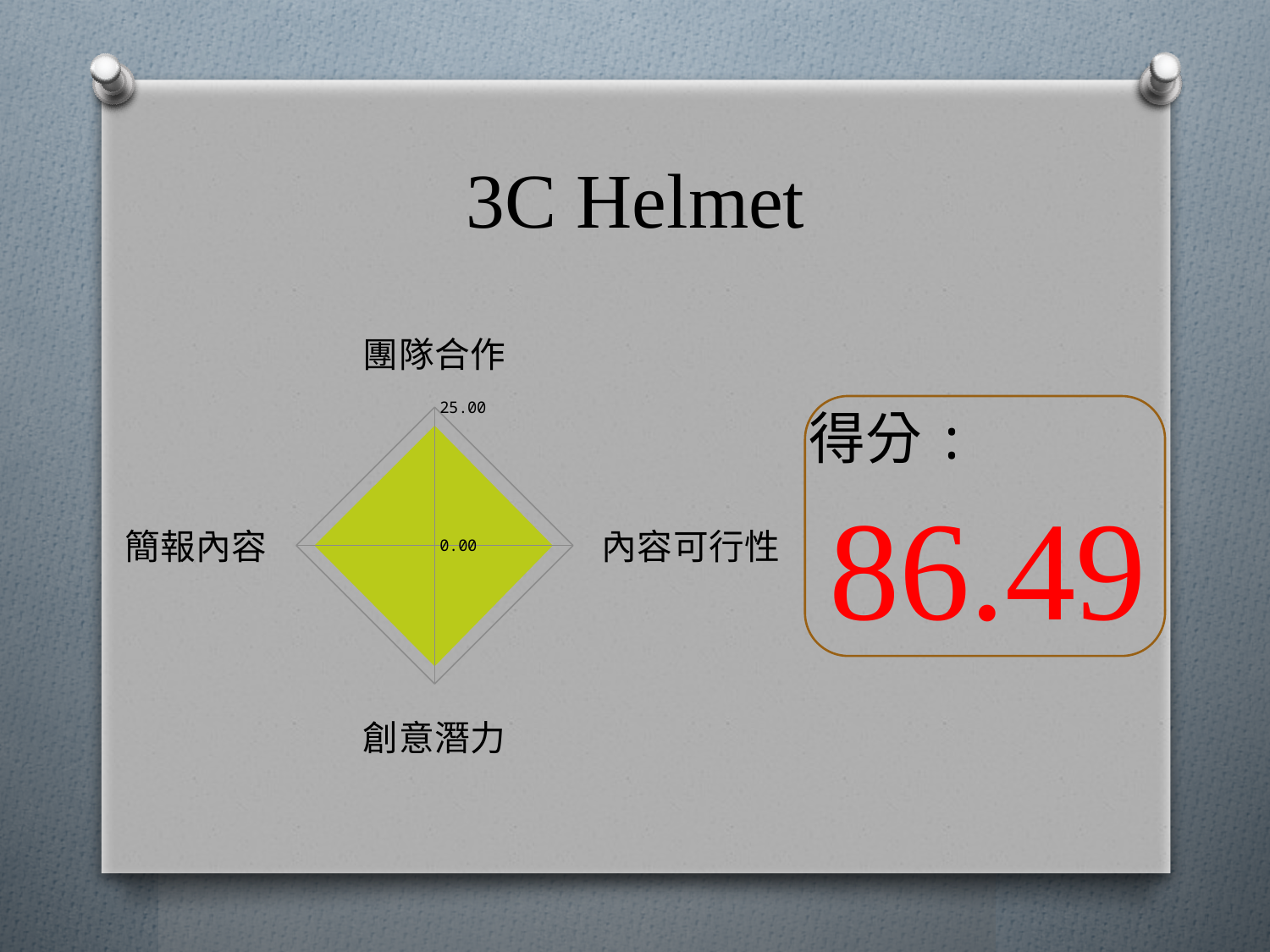
Which category label appears at the top of the radar chart? 團隊合作 Which category label appears at the bottom of the radar chart? 創意潛力 What is the maximum value shown on the radar chart's axis scale? 25.00 How many categories (axes) does the radar chart have? 4 What kind of chart is shown on the slide? Radar chart Which category label appears on the left side of the radar chart? 簡報內容 What is the minimum value shown on the radar chart's axis scale? 0.00 Which category label appears on the right side of the radar chart? 內容可行性